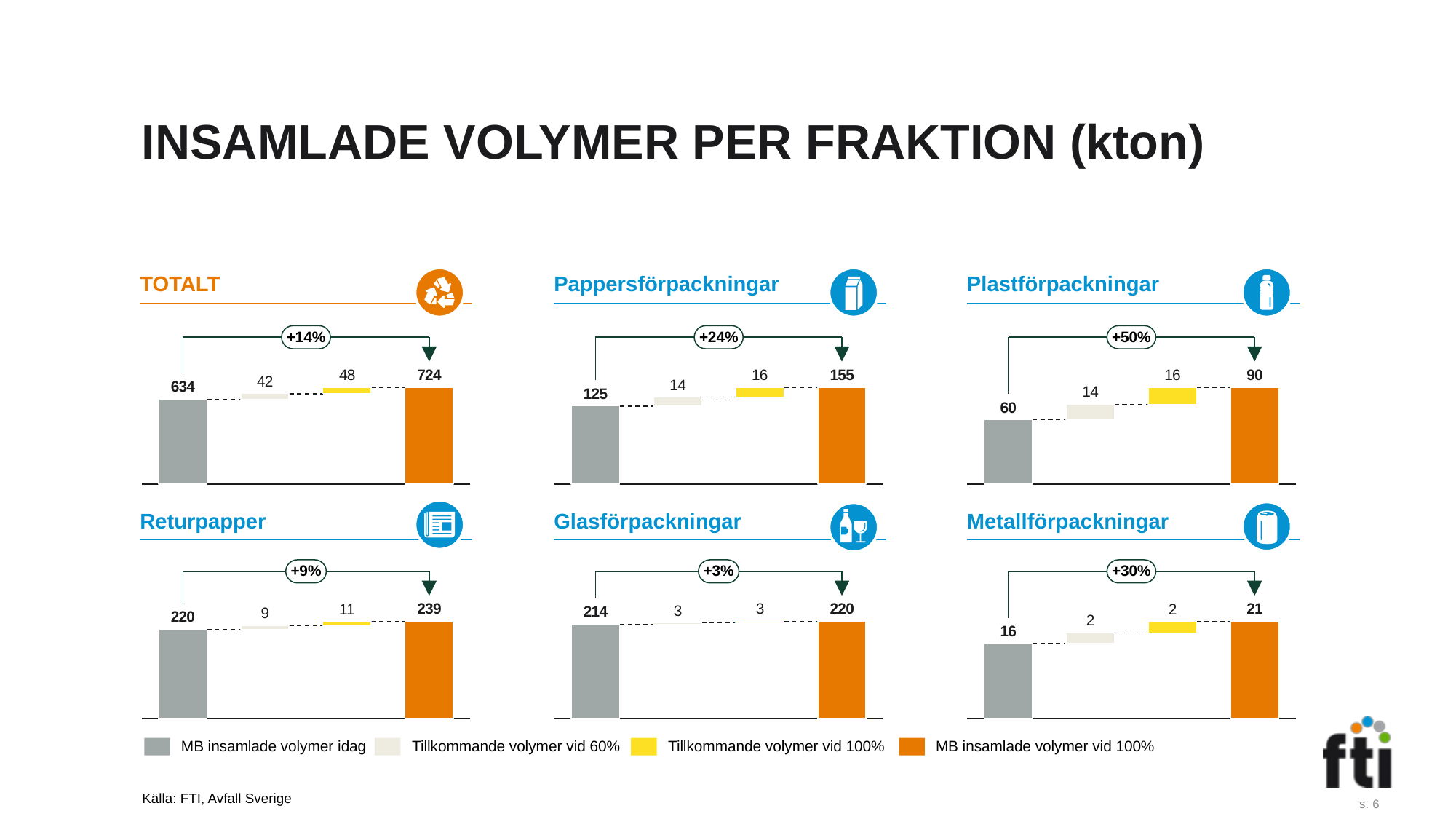
In the TOTALT chart, what is the value of MB insamlade volymer idag? 634 In the Plastförpackningar chart, what percentage increase is shown above the bars? +50% Which of the five fraction charts (excluding TOTALT) shows the highest value for MB insamlade volymer idag? Returpapper In the Returpapper chart, which is larger: Tillkommande volymer vid 60% or Tillkommande volymer vid 100%? Tillkommande volymer vid 100% In the Pappersförpackningar chart, what is the value of Tillkommande volymer vid 60%? 14 How many series does the legend at the bottom of the slide list? 4 Which of the five fraction charts (excluding TOTALT) shows the lowest value for MB insamlade volymer vid 100%? Metallförpackningar What kind of chart is used in each of the six panels on the slide? Bar chart In the Glasförpackningar chart, what is the difference between MB insamlade volymer vid 100% and MB insamlade volymer idag? 6 In the Metallförpackningar chart, what is the value of MB insamlade volymer vid 100%? 21 What colour represents MB insamlade volymer vid 100% in the legend? Orange In the TOTALT chart, what is the value of MB insamlade volymer vid 100%? 724